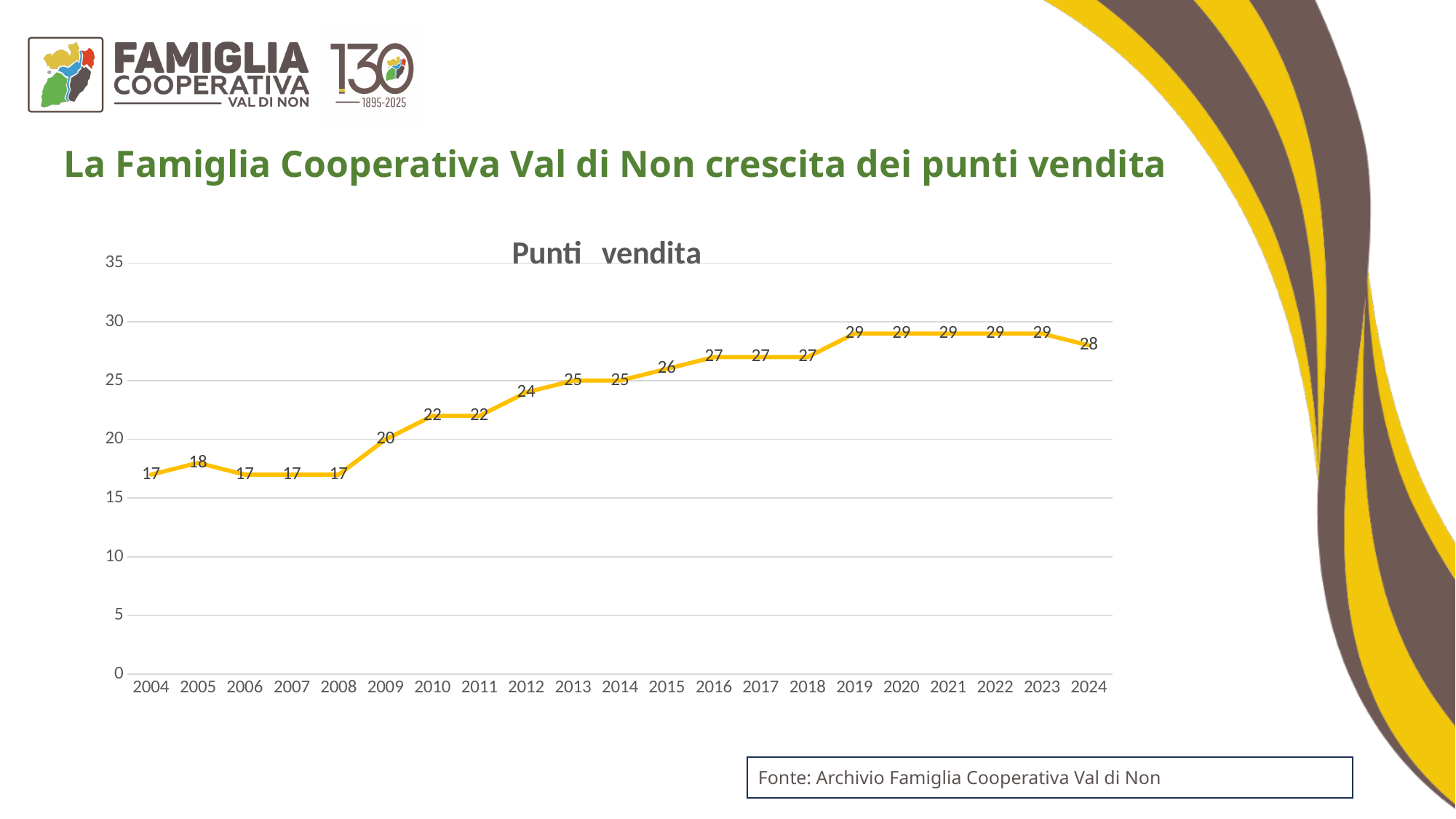
What kind of chart is shown? line chart What is the value for 2015? 26 What is the value for 2004? 17 Which is larger, the value for 2012 or the value for 2010? 2012 What is the value for 2009? 20 What is the highest value shown on the chart? 29 What is the value for 2024? 28 How many years are shown on the x axis? 21 Is the value for 2019 greater or less than 25? greater What is the title of the chart? Punti vendita What is the difference between the values for 2024 and 2004? 11 Which year has the lowest value? 2004, 2006, 2007 and 2008 (17)